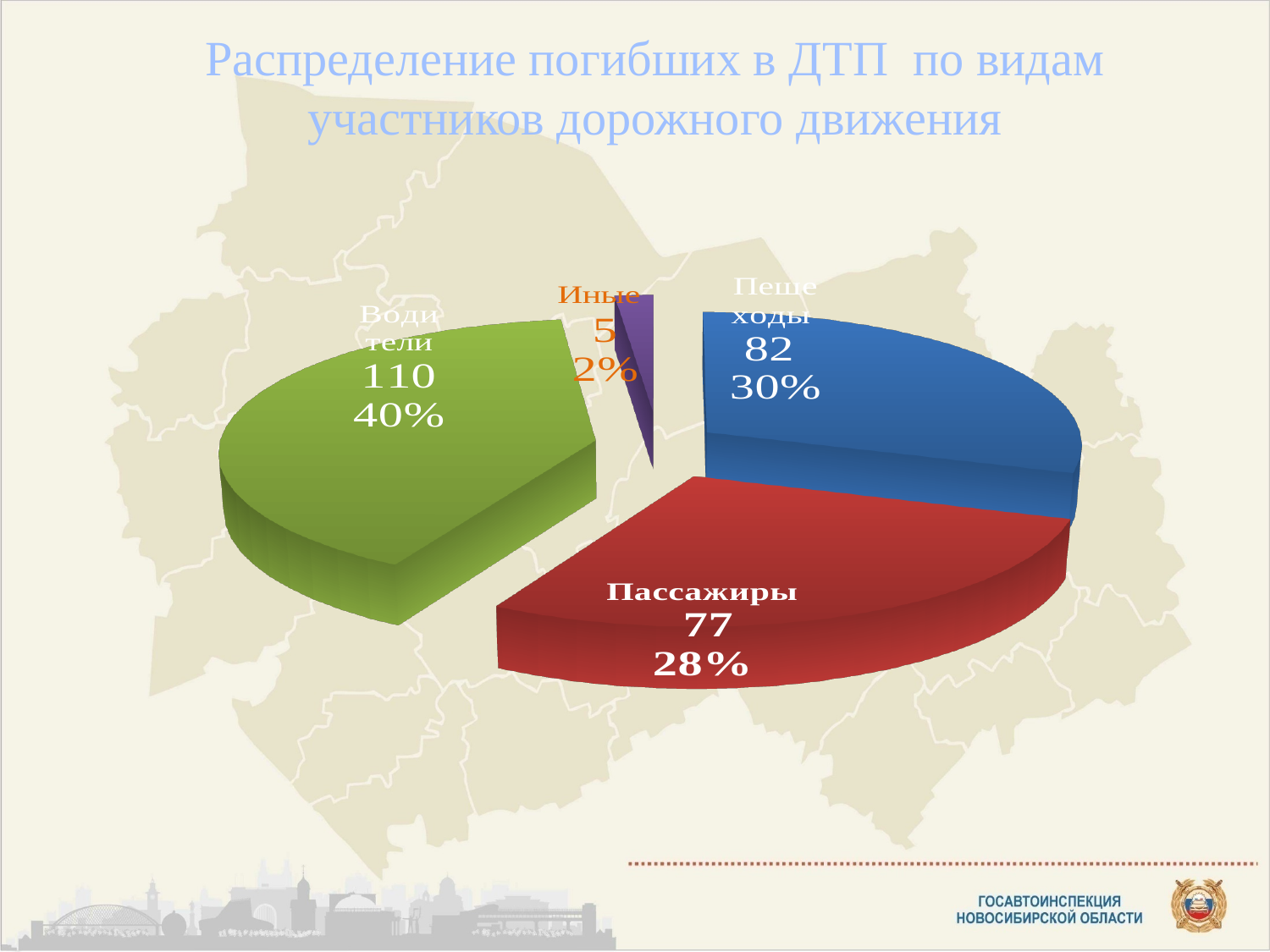
What is the value for Водители? 110 What share of the pie does Водители represent? 40% Which category has the smallest slice? Иные Which category has the largest slice? Водители What is the value for Пассажиры? 77 What kind of chart is shown on the slide? pie chart What is the value for Пешеходы? 82 What share of the pie does Пассажиры represent? 28% What is the value for Иные? 5 Which is larger, the value for Пешеходы or the value for Пассажиры? Пешеходы What is the difference between the values for Водители and Пешеходы? 28 How many slices does the pie chart have? 4